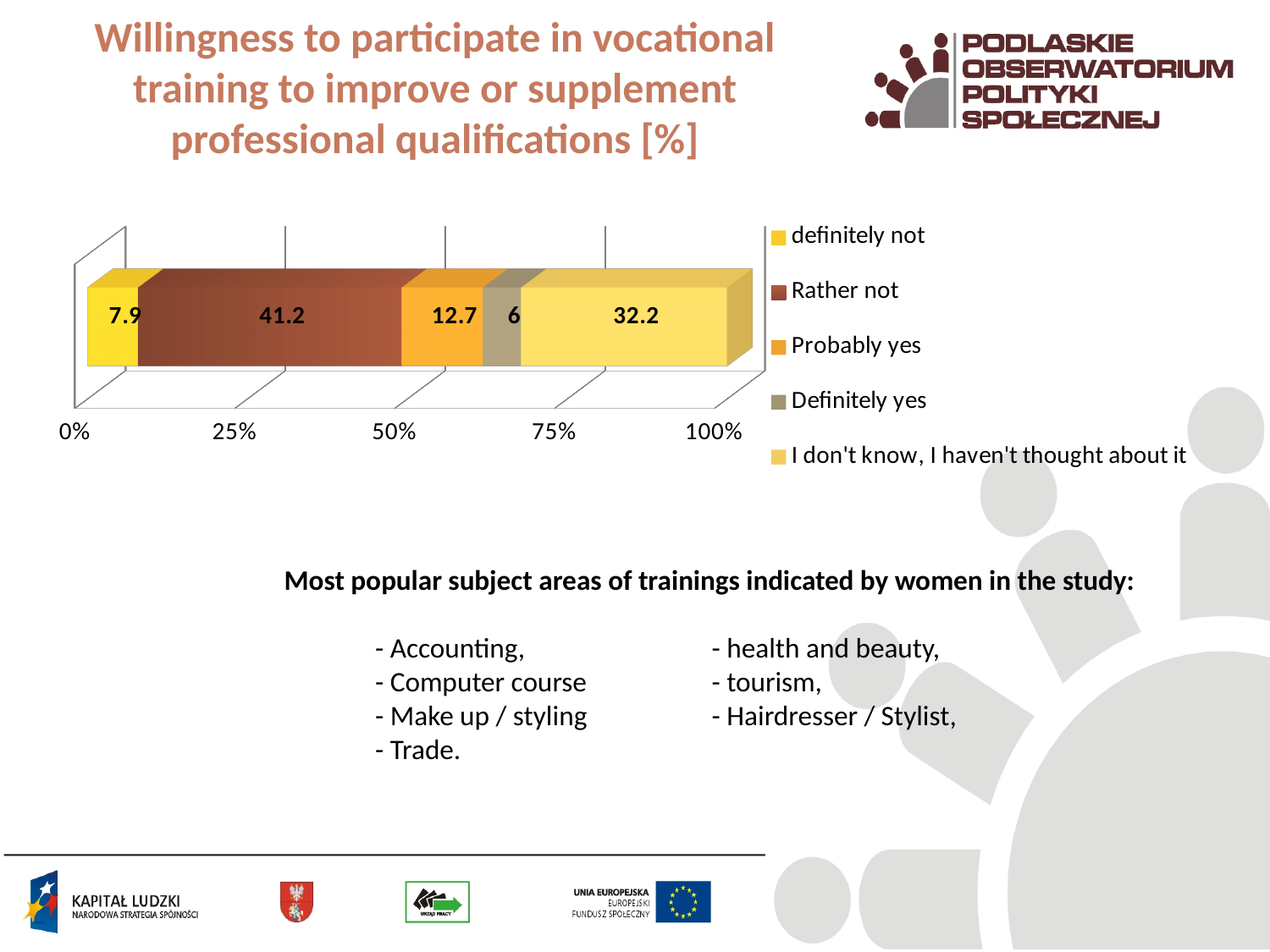
What is the value for "Definitely yes"? 6 What kind of chart is shown on the slide? Stacked bar chart What is the value for "I don't know, I haven't thought about it"? 32.2 Which legend entry is shown in the darkest red-brown colour? Rather not Which is larger, the value for "Probably yes" or the value for "definitely not"? Probably yes What is the total of the stacked bar? 100 What is the value for "definitely not"? 7.9 What is the difference between the values for "Rather not" and "Probably yes"? 28.5 Which response category has the highest value? Rather not What is the value for "Rather not"? 41.2 How many series does the legend list? 5 Which response category has the lowest value? Definitely yes